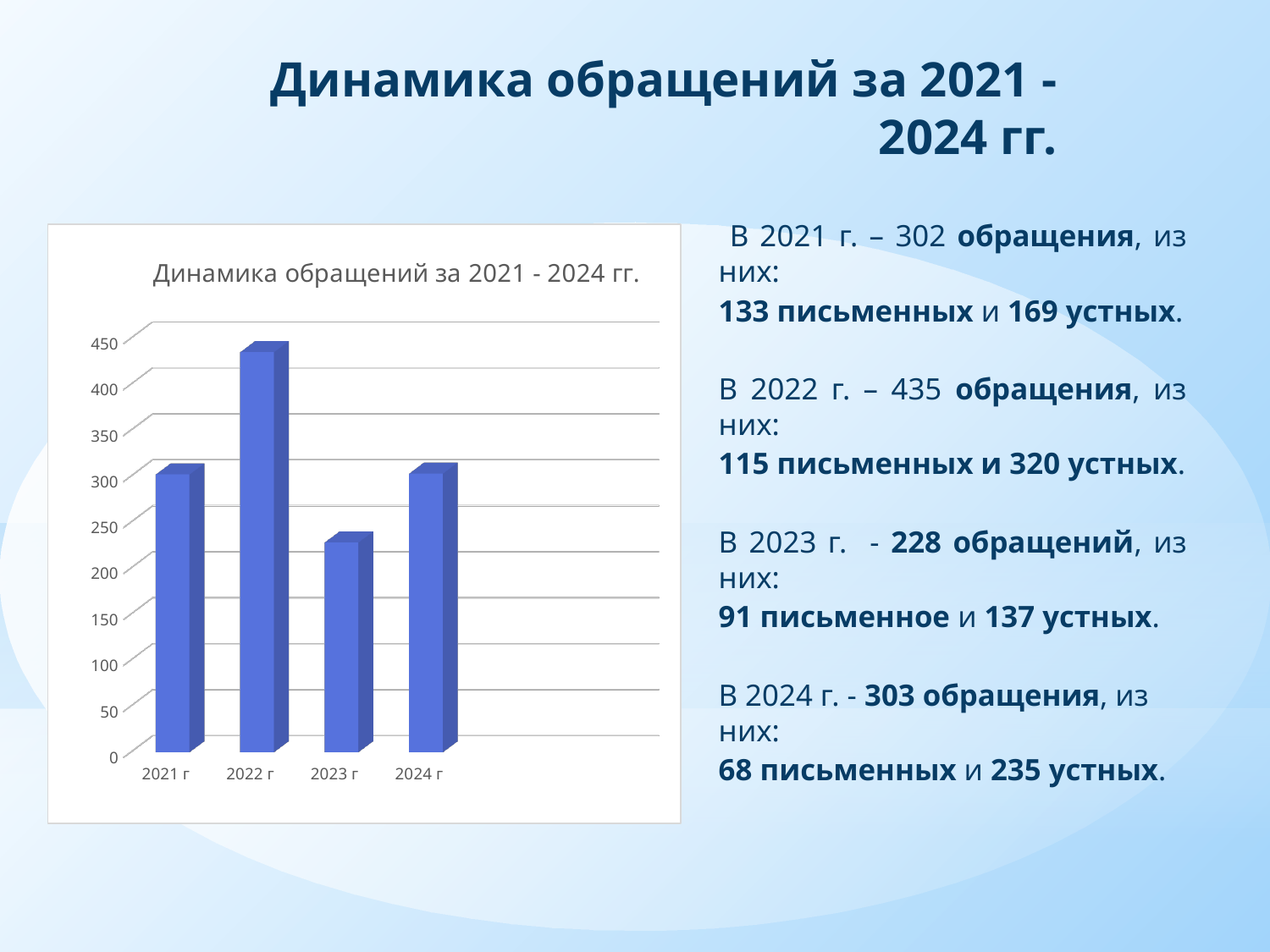
What kind of chart is shown on the slide? Bar chart Which bar is taller, 2021 г or 2023 г? 2021 г Which year has the highest bar in the chart? 2022 г What colour are the bars in the chart? Blue What is the title of the chart? Динамика обращений за 2021 - 2024 гг. Is the value for 2024 г greater or less than 250? greater Which year has the lowest bar in the chart? 2023 г Is the value for 2022 г greater or less than 400? greater Does the value rise or fall from 2022 г to 2023 г? fall How many years (categories) are plotted on the x axis of the chart? 4 Which bar is taller, 2022 г or 2023 г? 2022 г Is the value for 2023 г greater or less than 250? less